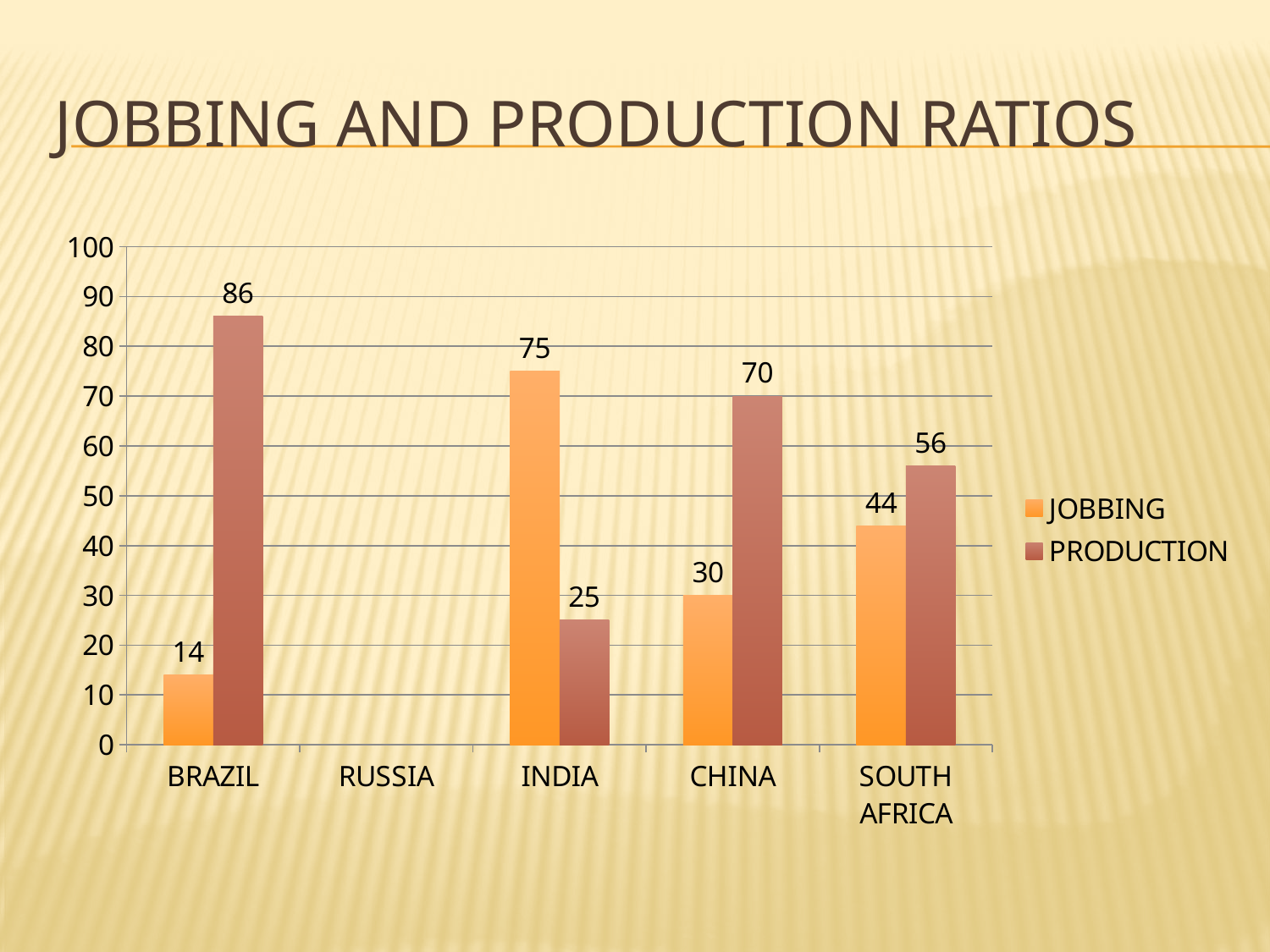
How many countries are listed on the x axis? 5 What is the difference between the PRODUCTION and JOBBING values for CHINA? 40 What kind of chart is shown on the slide? Bar chart Which is larger for INDIA, JOBBING or PRODUCTION? JOBBING What is the JOBBING value for SOUTH AFRICA? 44 What is the JOBBING value for INDIA? 75 What is the title of the slide? JOBBING AND PRODUCTION RATIOS Which country on the x axis has no bars plotted? RUSSIA What is the PRODUCTION value for BRAZIL? 86 How many series does the legend list? 2 Which country has the highest PRODUCTION value? BRAZIL Which country has the lowest JOBBING value among those with bars shown? BRAZIL